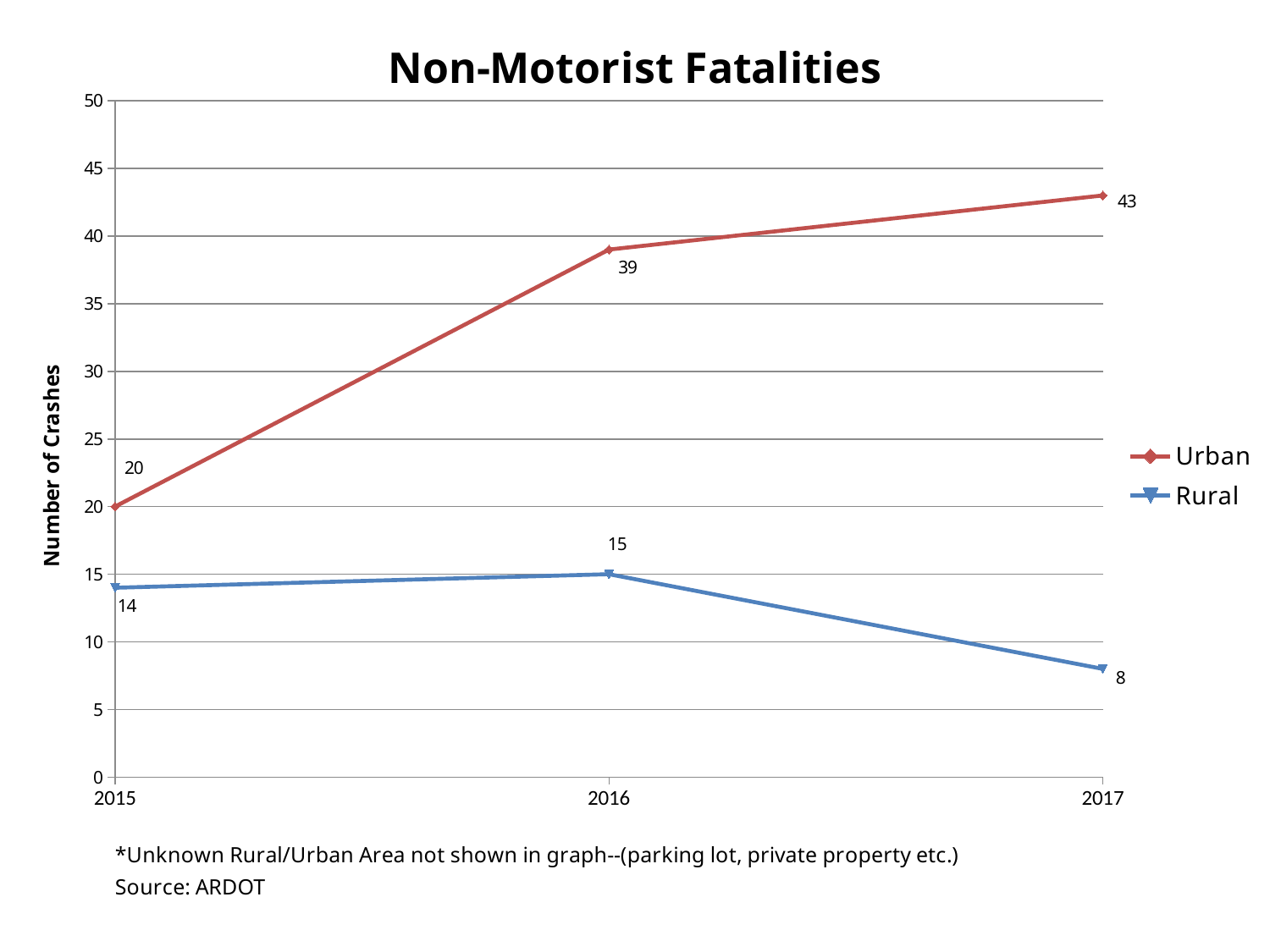
By how much did the Urban value increase from 2015 to 2016? 19 In which year is the Rural series lowest? 2017 What kind of chart is this? Line chart How many series does the legend list? 2 What is the Urban value for 2015? 20 Which series has the larger value in 2015, Urban or Rural? Urban Does the Urban series rise or fall from 2015 to 2017? Rise What is the Rural value for 2017? 8 What is the Urban value for 2016? 39 What is the difference between the Urban and Rural values in 2017? 35 In which year is the Urban series highest? 2017 How many years are shown on the x axis? 3